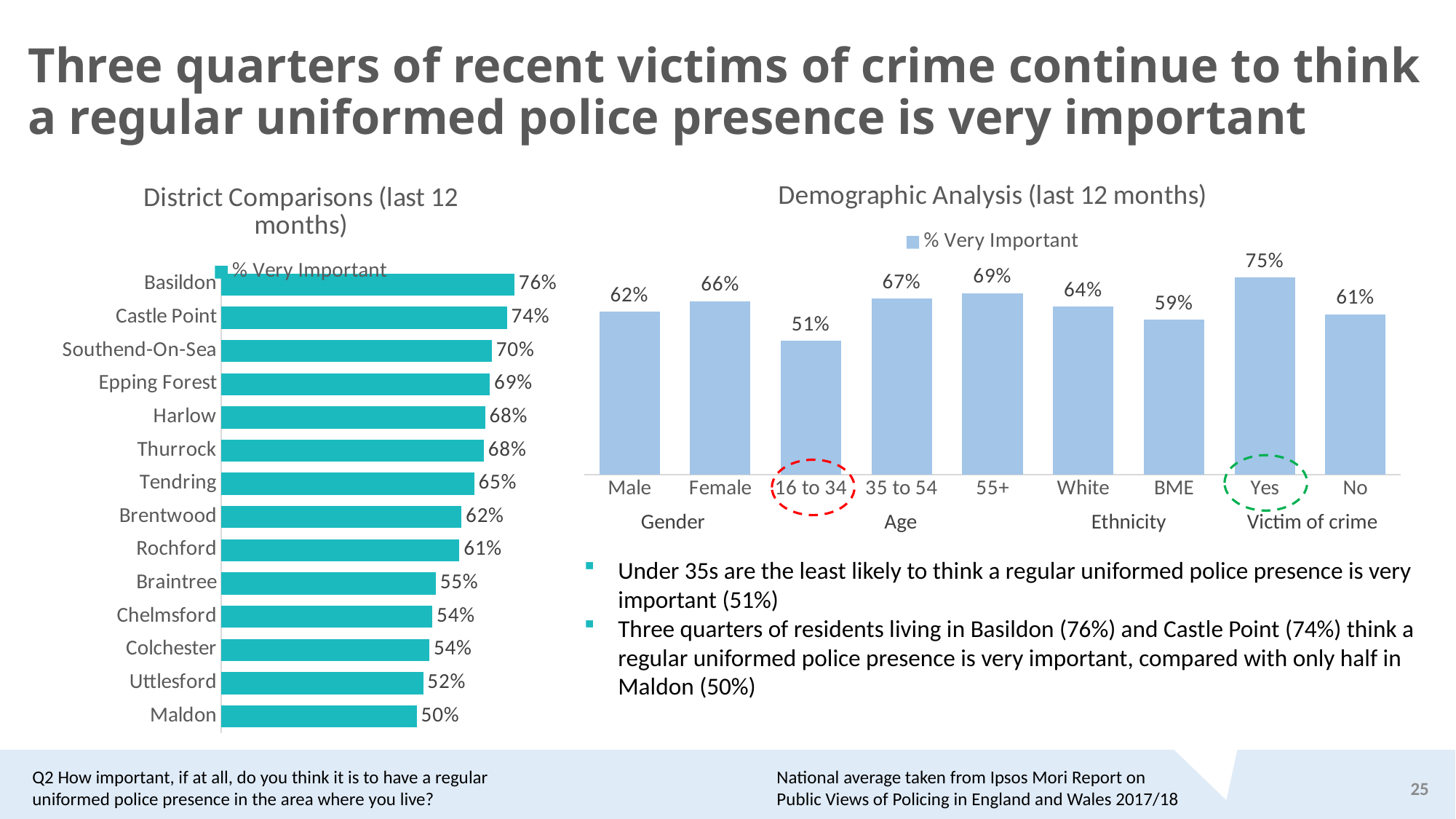
In the District Comparisons chart, what is the value for Southend-On-Sea? 70% In the District Comparisons chart, which district has the lowest value? Maldon In the District Comparisons chart, what is the difference between Basildon and Maldon? 26 percentage points What kind of chart is the Demographic Analysis chart? Bar chart In the District Comparisons chart, which district has the highest value? Basildon In the Demographic Analysis chart, what is the value for 16 to 34? 51% In the Demographic Analysis chart, what is the difference between Yes and No under Victim of crime? 14 percentage points In the Demographic Analysis chart, what series does the legend list? % Very Important In the District Comparisons chart, how many districts are shown? 14 In the Demographic Analysis chart, which category has the highest value? Yes In the District Comparisons chart, which is larger, Brentwood or Braintree? Brentwood In the Demographic Analysis chart, how many categories are plotted? 9